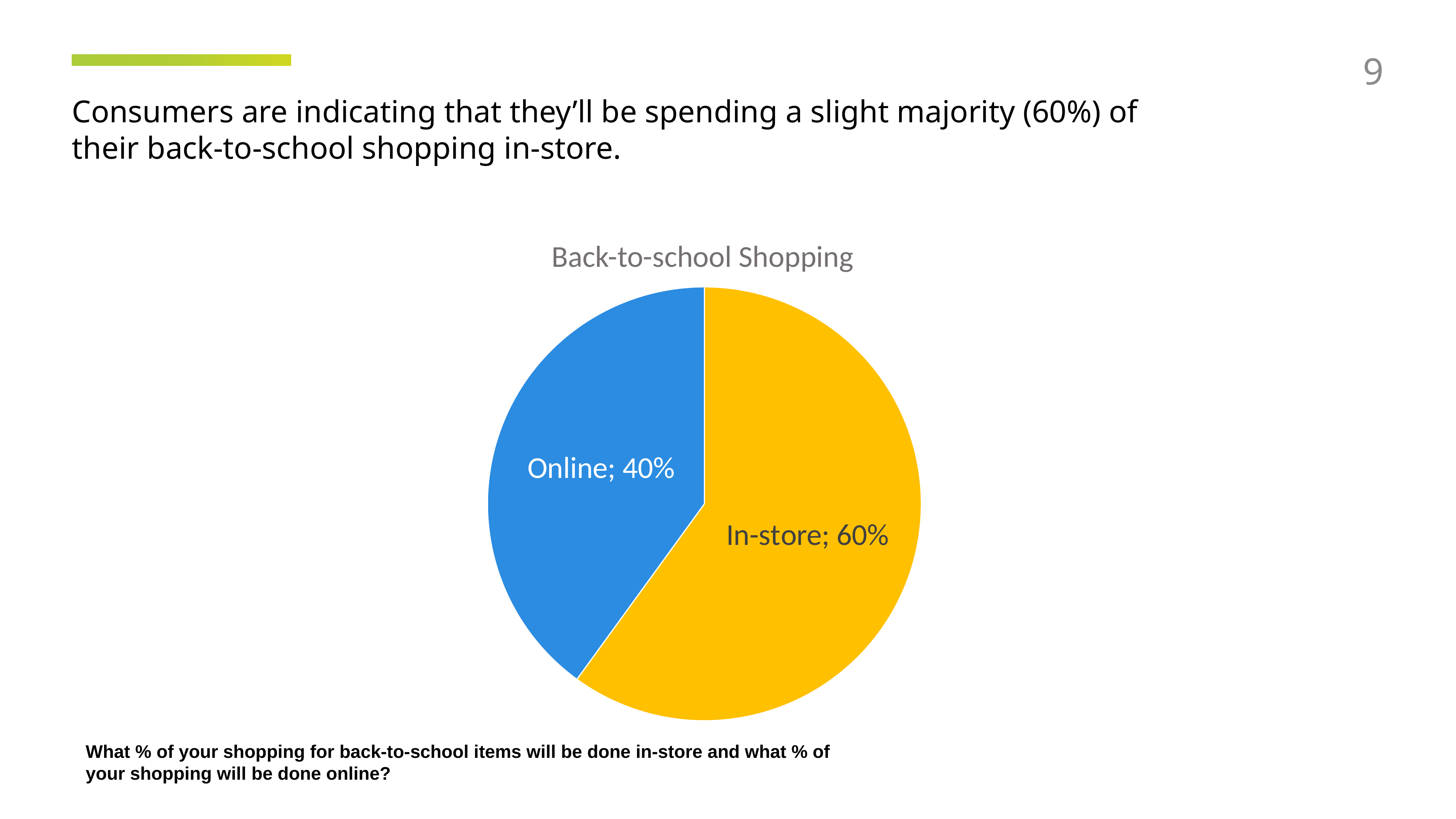
What kind of chart is shown on the slide? Pie chart What is the value for In-store in the pie chart? 60% What is the value for Online in the pie chart? 40% How many slices does the pie chart have? 2 Which slice of the pie chart is the largest? In-store What is the difference between the In-store and Online values? 20% What share of the pie does the Online slice represent? 40% Which is larger, the In-store slice or the Online slice? In-store Which slice of the pie chart is the smallest? Online What is the title of the chart? Back-to-school Shopping What colour is the In-store slice? Yellow